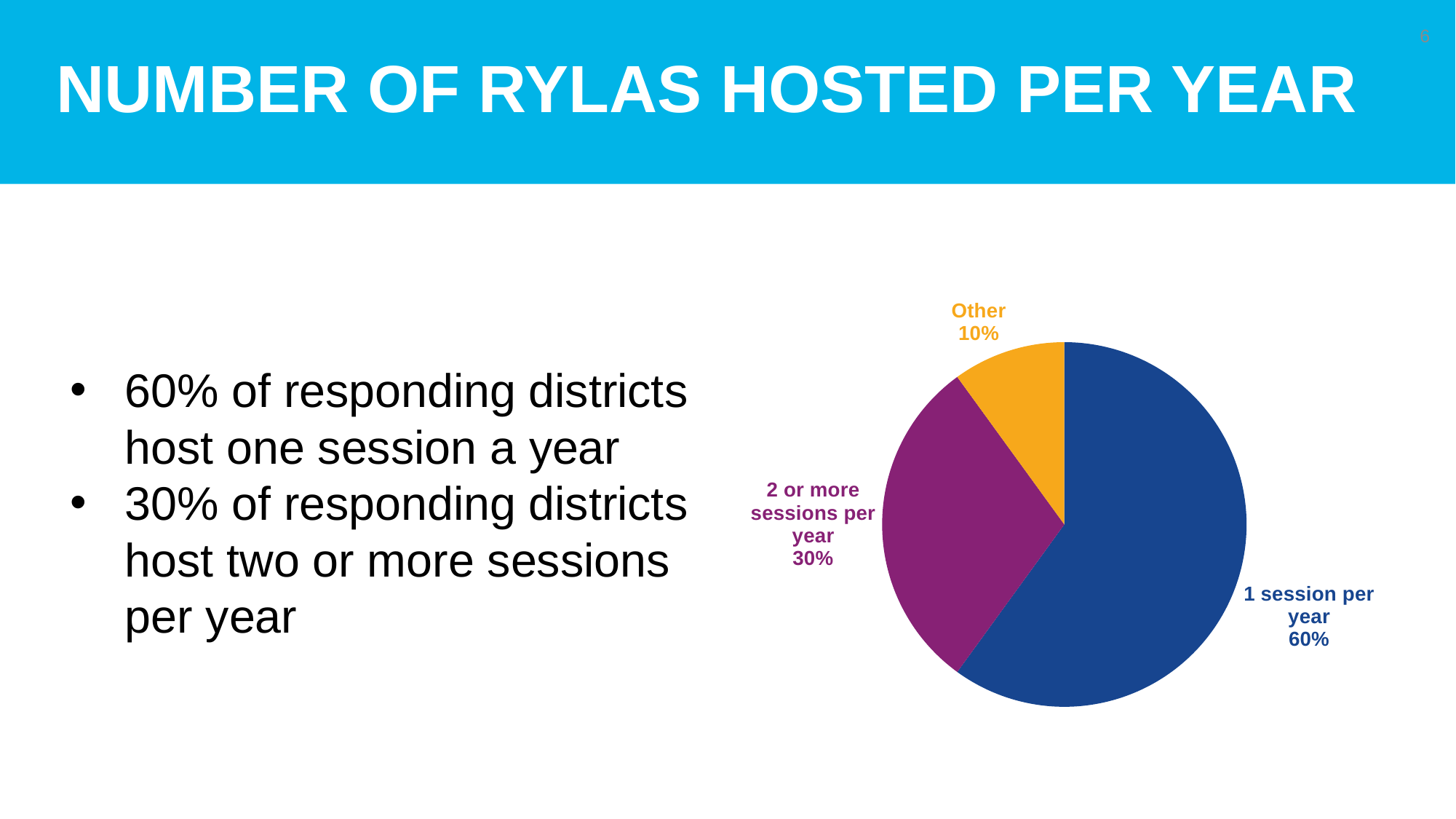
What share of the pie is labelled '1 session per year'? 60% Which is larger: the '2 or more sessions per year' slice or the 'Other' slice? 2 or more sessions per year What colour is the 'Other' slice? Orange What colour is the '1 session per year' slice? Blue How many slices does the pie chart have? 3 What is the difference in percentage points between the '2 or more sessions per year' slice and the 'Other' slice? 20% Which slice of the pie is the largest? 1 session per year What share of the pie is labelled '2 or more sessions per year'? 30% Which slice of the pie is the smallest? Other What kind of chart is shown on the slide? Pie chart What share of the pie is labelled 'Other'? 10% What is the difference in percentage points between the '1 session per year' slice and the '2 or more sessions per year' slice? 30%